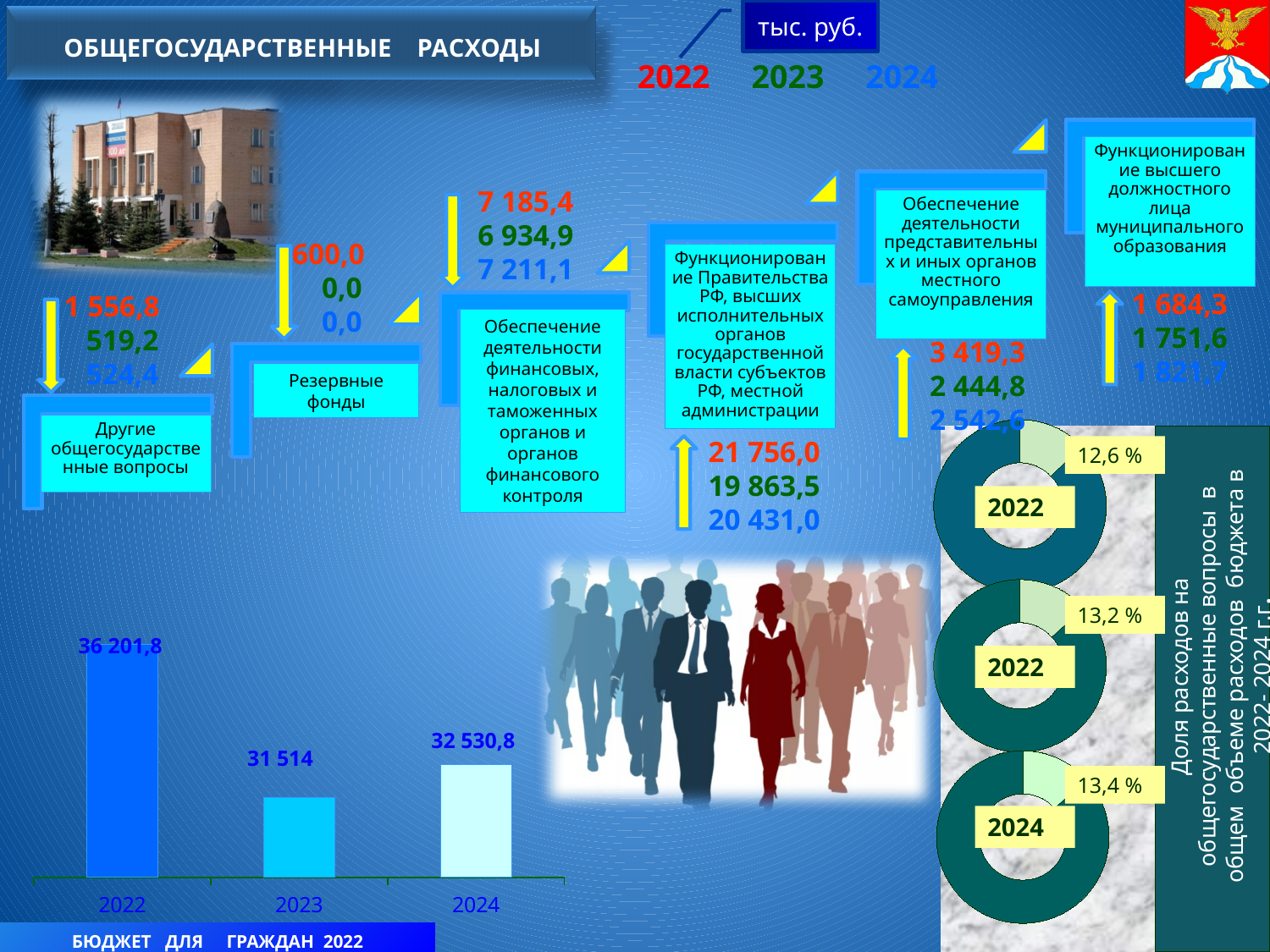
In the bar chart at the bottom left of the slide, which is larger, the value for 2023 or the value for 2024? 2024 In the bar chart at the bottom left of the slide, what is the difference between the values for 2024 and 2023? 1 016,8 In the bar chart at the bottom left of the slide, which year has the highest value? 2022 In the bar chart at the bottom left of the slide, does the value rise or fall from 2022 to 2023? fall How many bars are in the bar chart at the bottom left of the slide? 3 In the donut chart at the bottom right of the slide labelled 2024, what share is shown? 13,4 % What kind of chart is shown at the bottom left of the slide? bar chart In the bar chart at the bottom left of the slide, what is the difference between the values for 2022 and 2023? 4 687,8 In the bar chart at the bottom left of the slide, what is the value for 2024? 32 530,8 In the bar chart at the bottom left of the slide, what is the value for 2022? 36 201,8 In the bar chart at the bottom left of the slide, which year has the lowest value? 2023 In the bar chart at the bottom left of the slide, what is the value for 2023? 31 514